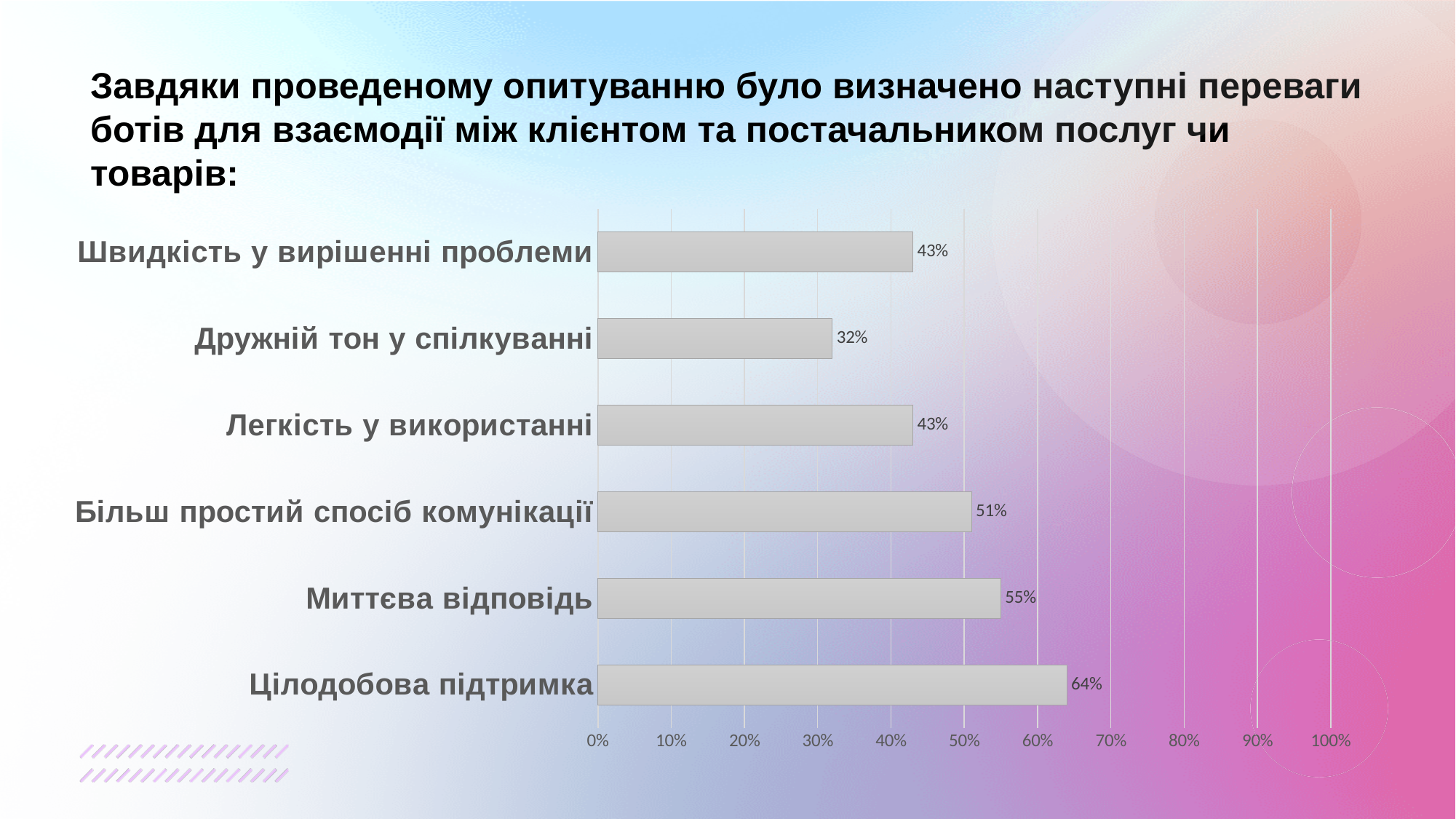
What is the difference between the values for Цілодобова підтримка and Дружній тон у спілкуванні? 32% What is the value for Більш простий спосіб комунікації? 51% What is the value for Цілодобова підтримка? 64% Is the value for Швидкість у вирішенні проблеми greater or less than 50%? less What is the difference between the values for Миттєва відповідь and Більш простий спосіб комунікації? 4% Which category has the highest value? Цілодобова підтримка Which is larger, the value for Миттєва відповідь or the value for Легкість у використанні? Миттєва відповідь What kind of chart is shown on the slide? bar chart What is the value for Дружній тон у спілкуванні? 32% Which category has the lowest value? Дружній тон у спілкуванні How many categories are shown in the chart? 6 What is the value for Миттєва відповідь? 55%